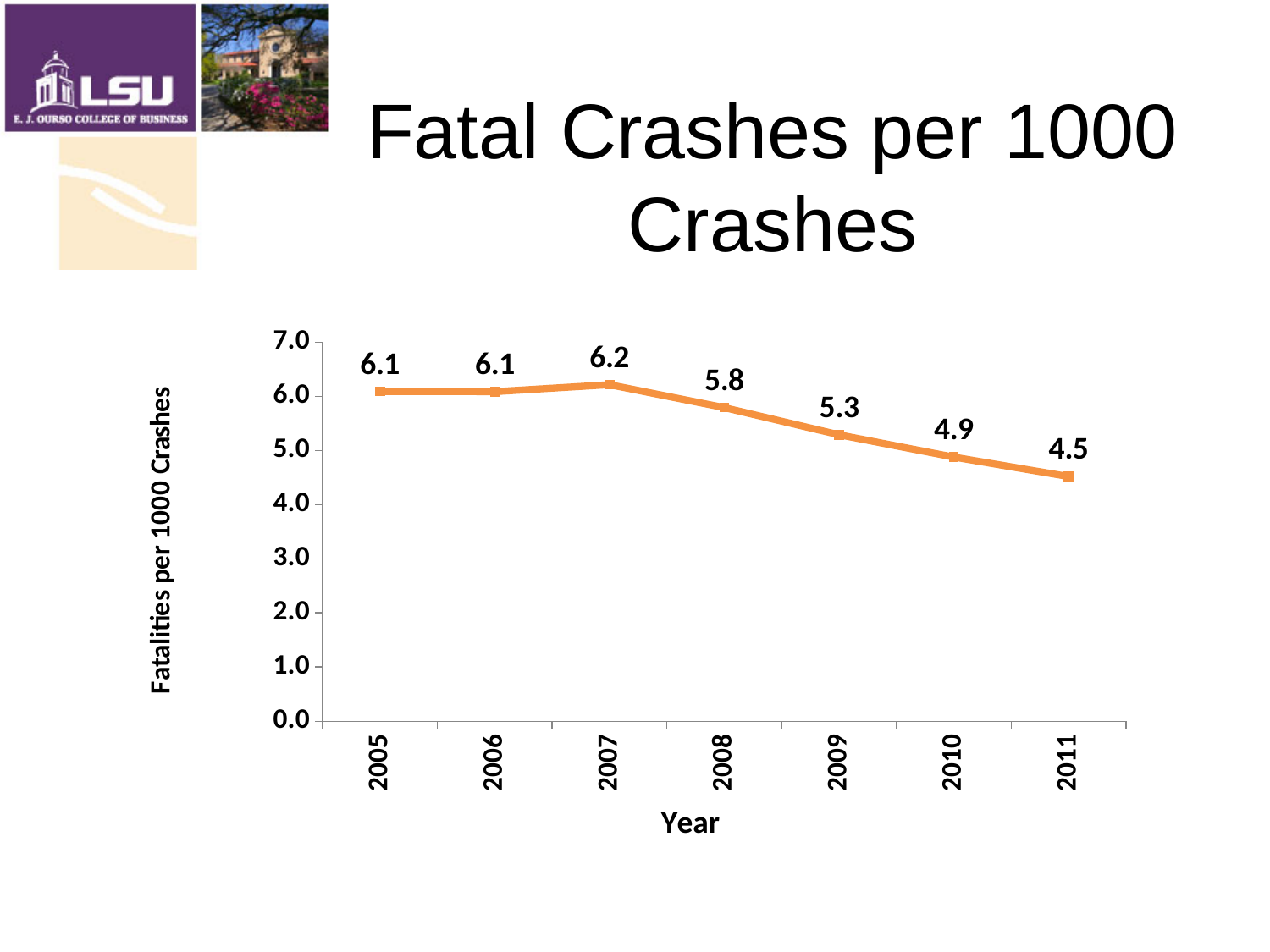
Which is larger, the value for 2009 or the value for 2010? 2009 What kind of chart is shown? line chart What is the value for 2008? 5.8 Is the value for 2010 greater or less than 5.0? less What is the value for 2011? 4.5 What is the difference between the values for 2008 and 2009? 0.5 What is the difference between the values for 2007 and 2011? 1.7 How many years are plotted on the chart? 7 Which year has the highest value? 2007 What is the value for 2005? 6.1 Which year has the lowest value? 2011 Do the values rise or fall from 2007 to 2011? fall